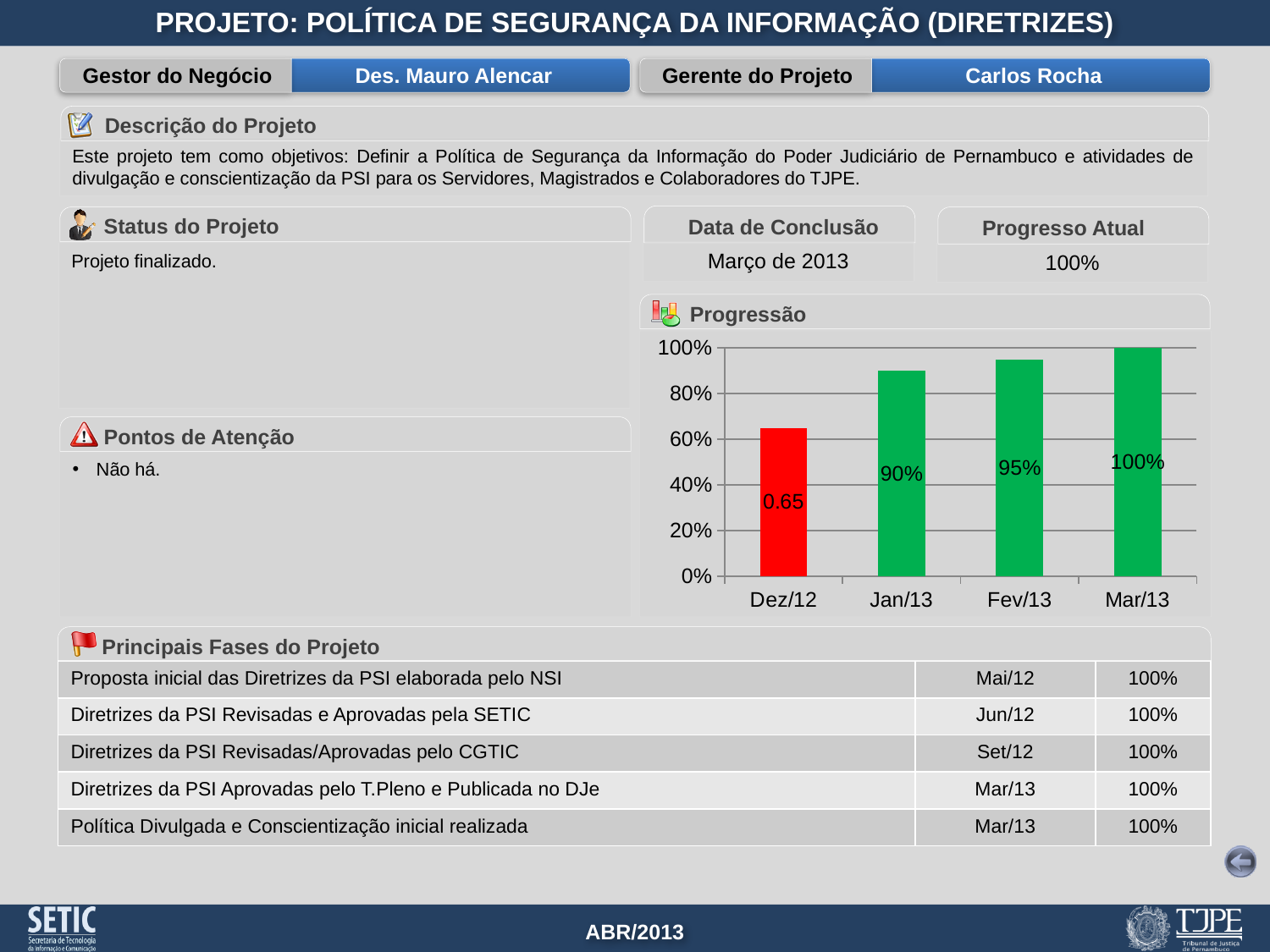
What type of chart is shown under "Progressão"? bar chart How many categories are shown on the x axis of the Progressão chart? 4 In the Progressão chart, what is the difference between the values for Mar/13 and Jan/13? 10% What is the value shown for Mar/13 in the Progressão chart? 100% Do the values in the Progressão chart rise or fall from Dez/12 to Mar/13? rise Is the value for Dez/12 in the Progressão chart greater or less than 60%? greater What data label is printed on the Dez/12 bar in the Progressão chart? 0.65 What is the value shown for Fev/13 in the Progressão chart? 95% Which month has the highest value in the Progressão chart? Mar/13 What is the value shown for Jan/13 in the Progressão chart? 90% Which month has the lowest value in the Progressão chart? Dez/12 In the Progressão chart, which is larger: the value for Fev/13 or the value for Jan/13? Fev/13